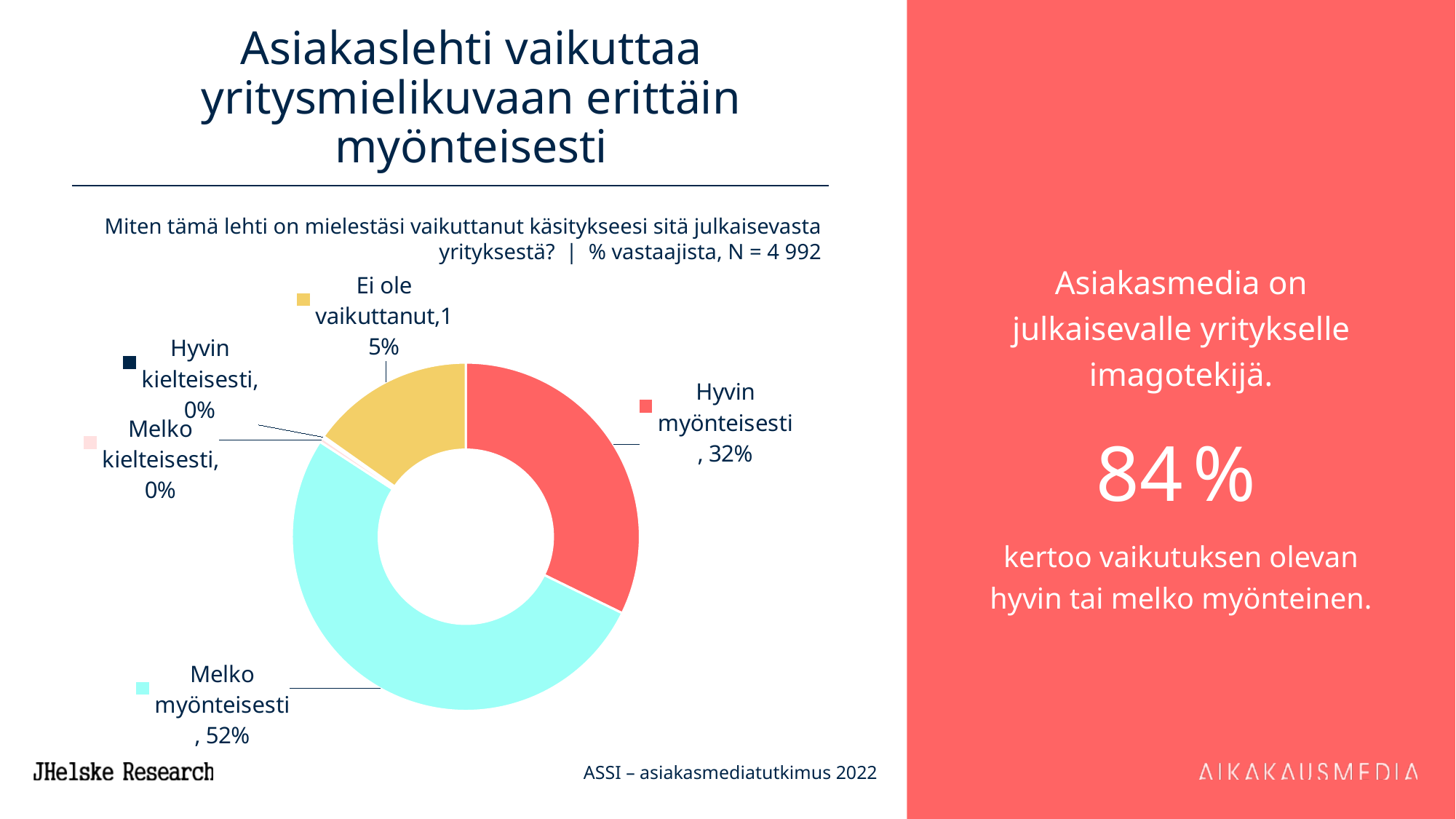
What is the value for "Ei ole vaikuttanut"? 15% What is the value for "Melko myönteisesti"? 52% Which is larger, "Hyvin myönteisesti" or "Ei ole vaikuttanut"? Hyvin myönteisesti What is the value for "Hyvin myönteisesti"? 32% Which category has the largest share? Melko myönteisesti How many categories are shown in the chart? 5 What is the combined share of "Hyvin myönteisesti" and "Melko myönteisesti"? 84% What kind of chart is shown on the slide? Doughnut chart What colour is the "Ei ole vaikuttanut" segment? Yellow What is the difference between "Melko myönteisesti" and "Hyvin myönteisesti"? 20% What is the number of respondents (N) stated above the chart? 4 992 What is the value for "Melko kielteisesti"? 0%